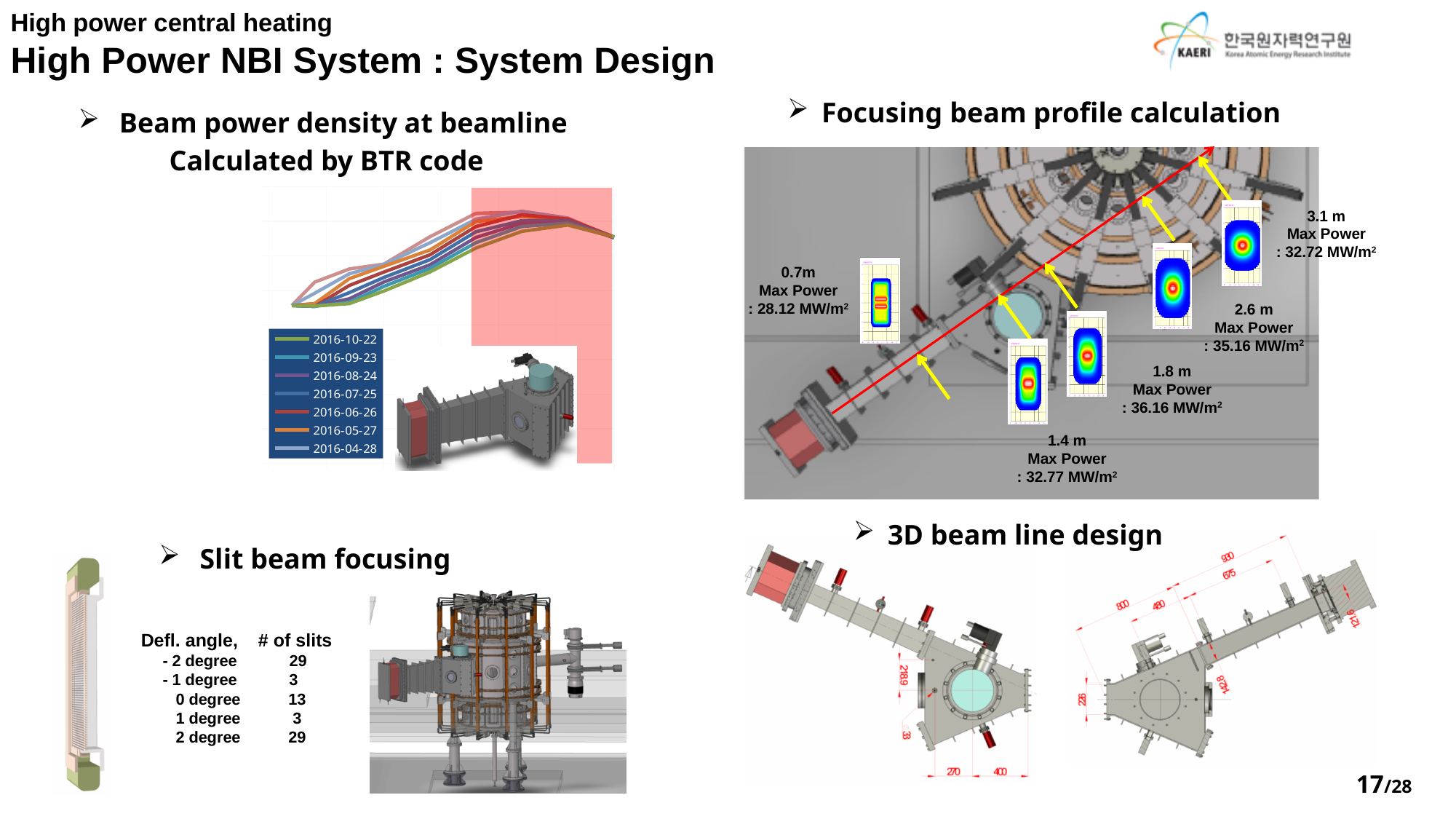
In the 'Beam power density at beamline' chart, which date is the first entry in the legend? 2016-10-22 In the 'Beam power density at beamline' chart, which date is the last entry in the legend? 2016-04-28 In the 'Beam power density at beamline' chart, do the lines rise or fall from the leftmost point toward the middle of the x axis? rise How many series does the legend of the 'Beam power density at beamline' chart list? 7 What kind of chart is shown under 'Beam power density at beamline Calculated by BTR code'? line chart